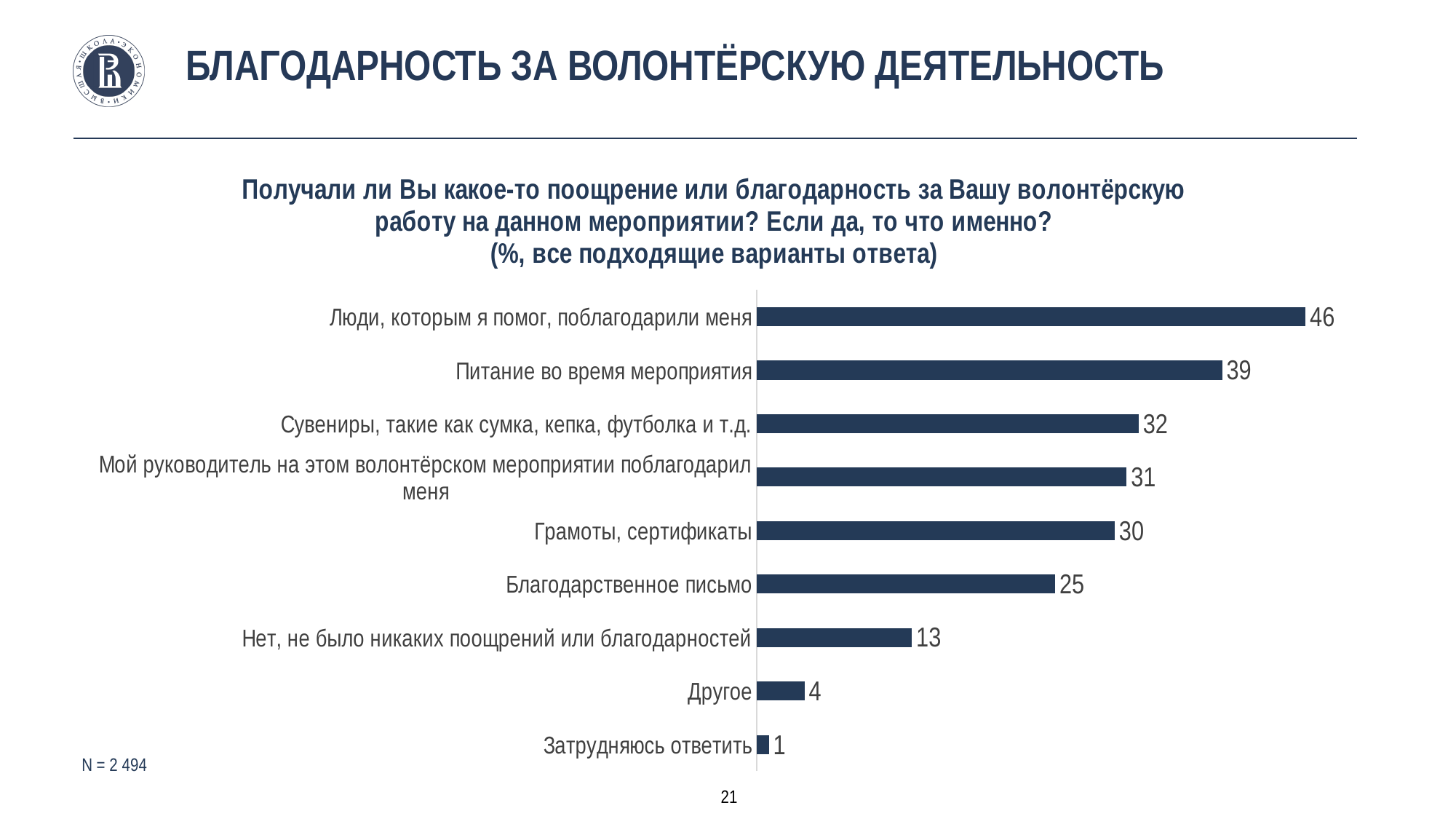
What is the difference between the values for "Другое" and "Затрудняюсь ответить"? 3 What kind of chart is shown on the slide? Bar chart Which category has the lowest value? Затрудняюсь ответить What is the difference between the values for "Питание во время мероприятия" and "Сувениры, такие как сумка, кепка, футболка и т.д."? 7 What is the value for "Питание во время мероприятия"? 39 What is the value for "Люди, которым я помог, поблагодарили меня"? 46 What is the value for "Благодарственное письмо"? 25 Which category has the highest value? Люди, которым я помог, поблагодарили меня What is the value for "Нет, не было никаких поощрений или благодарностей"? 13 How many categories are shown in the chart? 9 Which is larger: the value for "Грамоты, сертификаты" or the value for "Благодарственное письмо"? Грамоты, сертификаты What sample size (N) is stated on the slide? N = 2 494